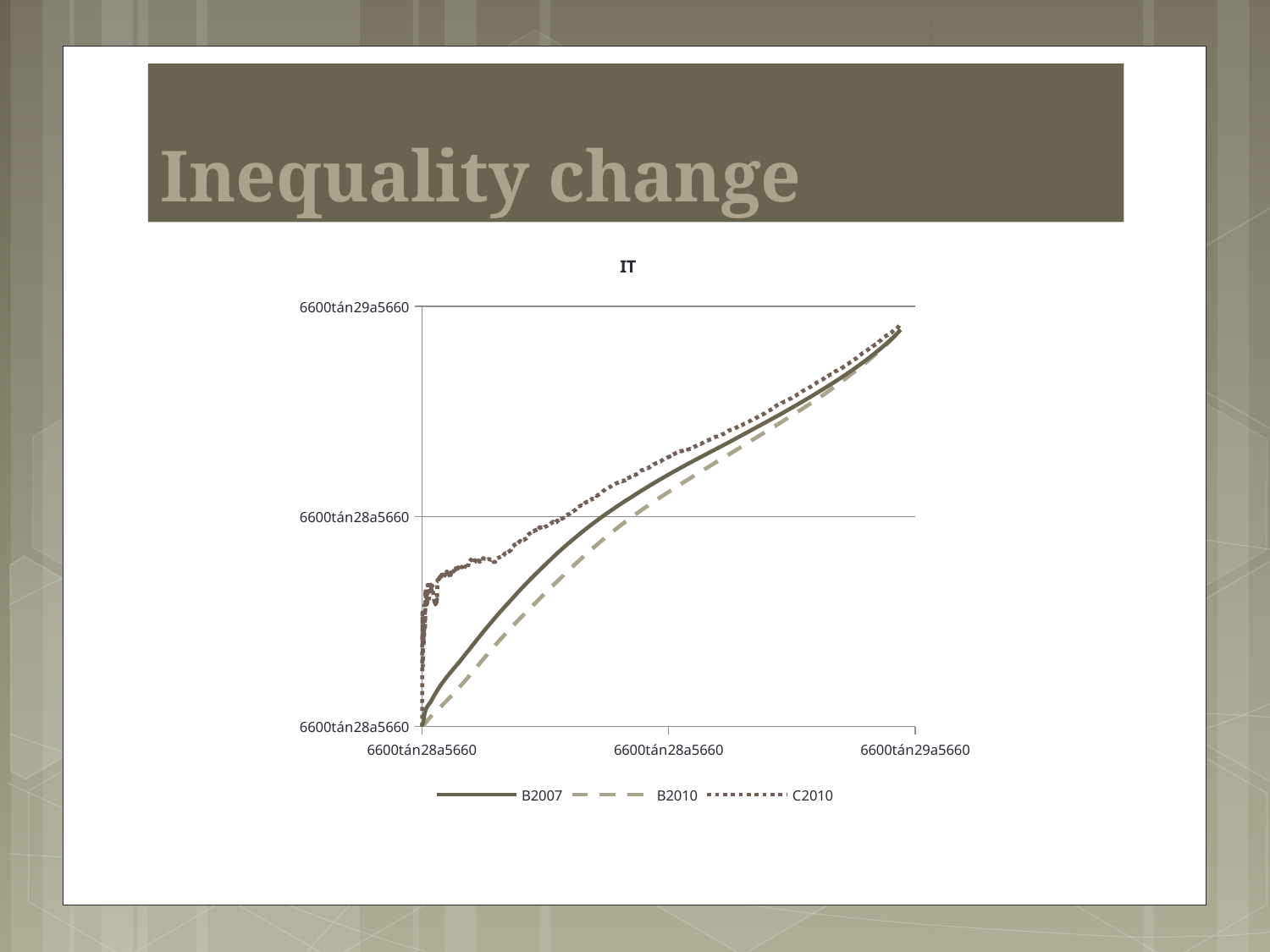
What is the title of the chart? IT Around the middle of the x axis, which of the three series has the highest value? C2010 Around the middle of the x axis, which series is higher, B2010 or C2010? C2010 What kind of chart is shown on the slide? line chart How many series does the legend of the chart list? 3 Do the values of the B2007 series rise or fall as you move from left to right along the x axis? rise Which series in the chart is drawn with a dotted line? C2010 Around the middle of the x axis, which series is higher, B2007 or B2010? B2007 Do the values of the B2010 series rise or fall as you move from left to right along the x axis? rise Around the middle of the x axis, which of the three series has the lowest value? B2010